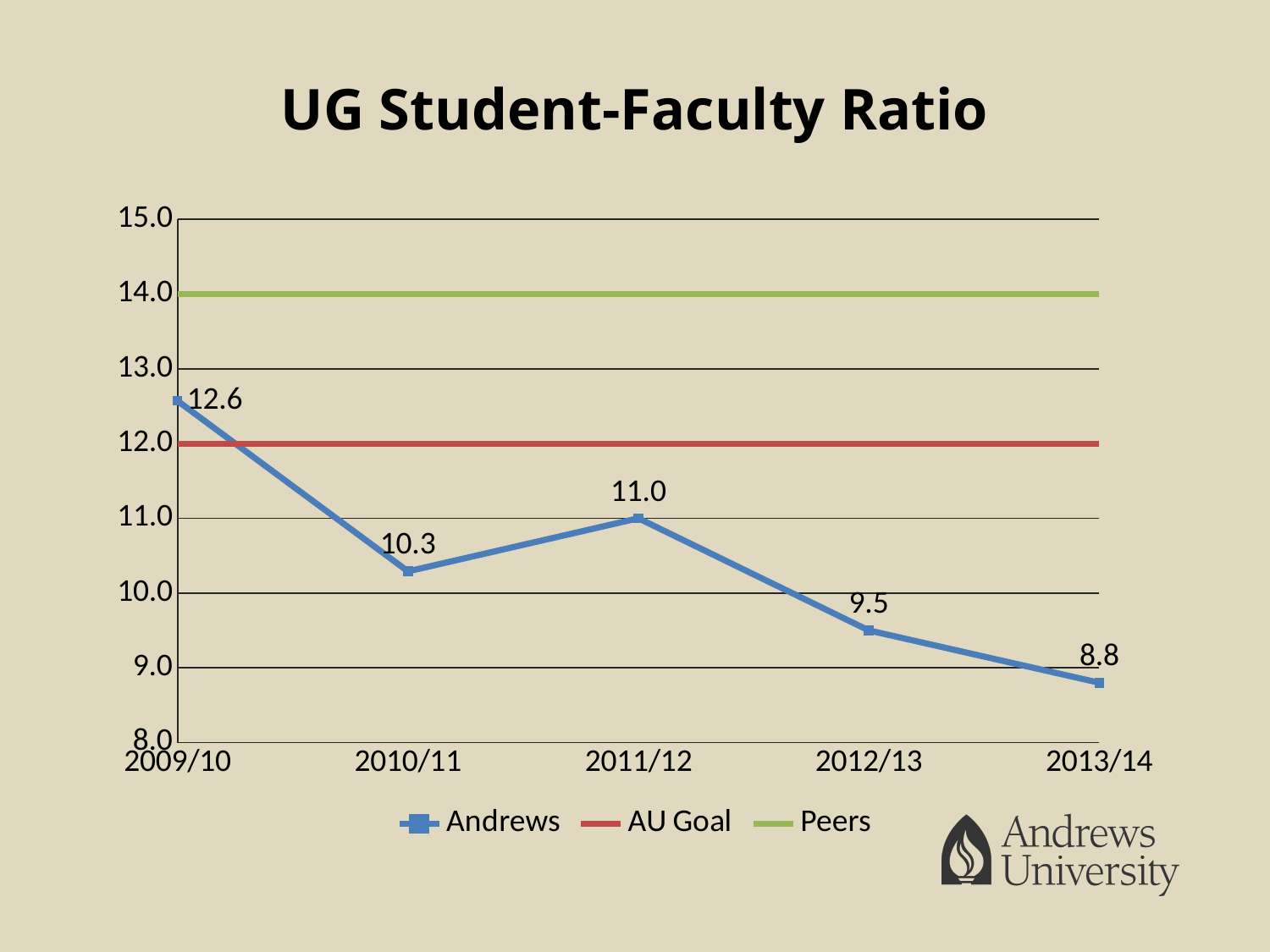
Which is larger, the Andrews value for 2010/11 or for 2011/12? 2011/12 What kind of chart is this? Line chart In which year is the Andrews ratio highest? 2009/10 In which year is the Andrews ratio lowest? 2013/14 What is the Andrews value for 2011/12? 11.0 What value does the Peers line sit at? 14.0 What value does the AU Goal line sit at? 12.0 What is the Andrews value for 2013/14? 8.8 What is the Andrews UG student-faculty ratio for 2009/10? 12.6 How many years are shown on the x axis? 5 What is the difference between the Andrews values for 2009/10 and 2013/14? 3.8 How many series does the legend list? 3